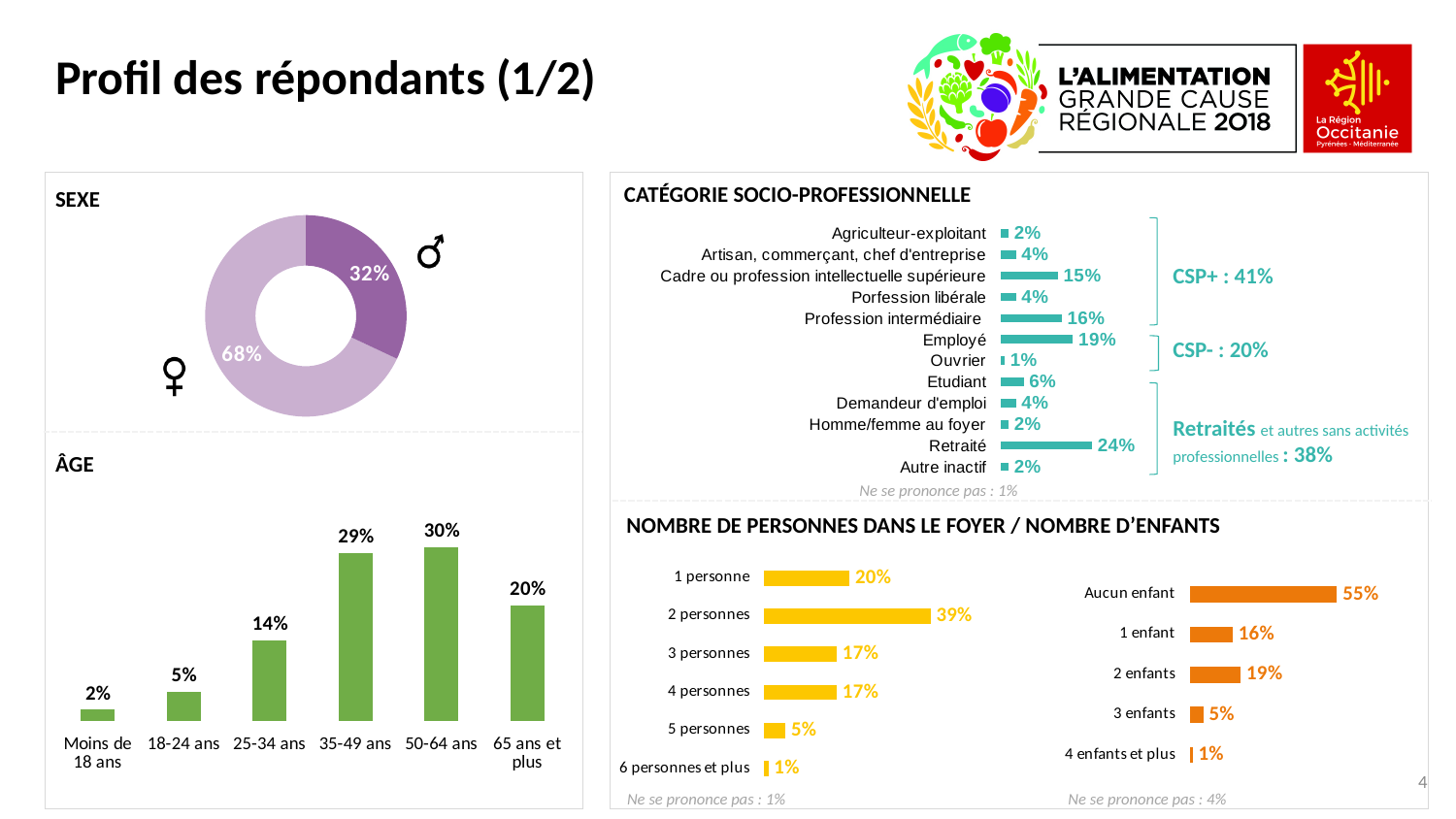
In the ÂGE chart, how many age categories are shown? 6 In the ÂGE chart, which age group has the lowest value? Moins de 18 ans In the SEXE chart, what share of respondents are women? 68% In the CATÉGORIE SOCIO-PROFESSIONNELLE chart, which is larger: Cadre ou profession intellectuelle supérieure or Profession intermédiaire? Profession intermédiaire In the ÂGE chart, what is the value for 50-64 ans? 30% In the NOMBRE D'ENFANTS chart, what is the difference between 2 enfants and 1 enfant? 3% In the ÂGE chart, what is the difference between 35-49 ans and 25-34 ans? 15% In the CATÉGORIE SOCIO-PROFESSIONNELLE chart, which category has the highest value? Retraité In the NOMBRE D'ENFANTS chart, what is the value for Aucun enfant? 55% What kind of chart is the SEXE chart? Donut (pie) chart In the CATÉGORIE SOCIO-PROFESSIONNELLE chart, what is the value for Employé? 19% In the NOMBRE DE PERSONNES DANS LE FOYER chart, what is the value for 2 personnes? 39%